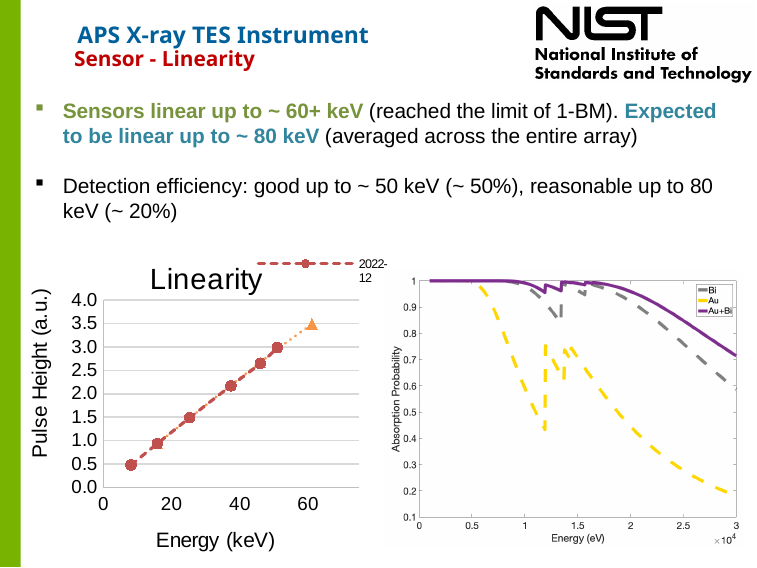
In the Linearity chart, what is the label of the y axis? Pulse Height (a.u.) How many series does the legend of the Absorption Probability chart on the right list? 3 In the Linearity chart, does the pulse height rise or fall as energy increases? Rise How many series does the legend of the Linearity chart list? 1 In the Linearity chart, is the pulse height of the lowest-energy point (near 8 keV) greater or less than 1.0? less In the Linearity chart, what is the label of the x axis? Energy (keV) What kind of chart is the Absorption Probability chart on the right of the slide? Line chart What kind of chart is the Linearity chart on the left of the slide? Scatter (line) chart In the Absorption Probability chart, which series has the lowest absorption probability at the right end of the x axis (3 ×10^4 eV)? Au In the Linearity chart, is the pulse height of the triangular point near 60 keV greater or less than 3.0? greater In the Absorption Probability chart, does the Au curve rise or fall as energy increases from 1 ×10^4 to 3 ×10^4 eV? Fall In the Absorption Probability chart, is the absorption probability of Au at 3 ×10^4 eV greater or less than 0.3? less